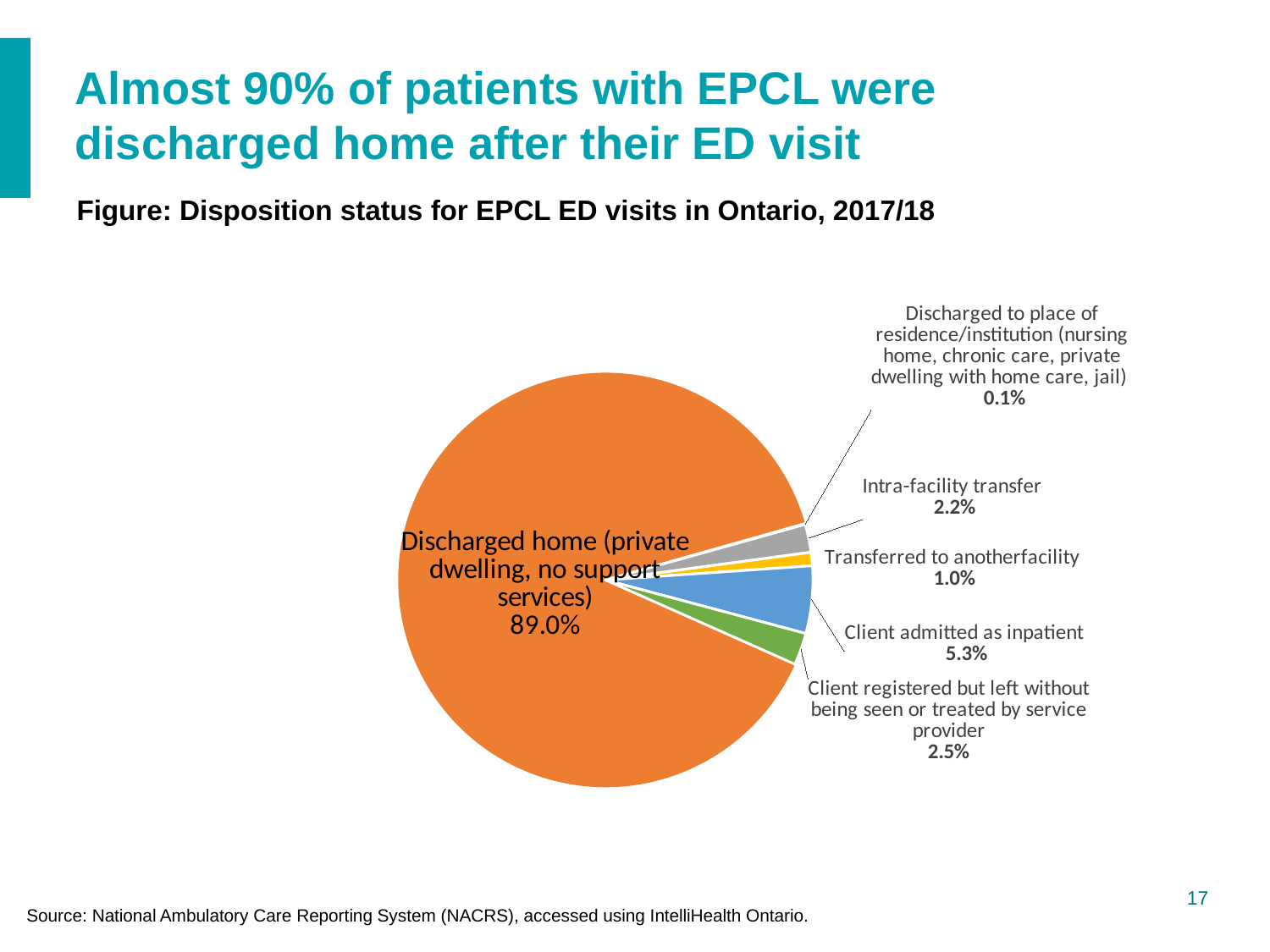
How many disposition categories are shown in the pie chart? 6 Which disposition status has the smallest share of the pie? Discharged to place of residence/institution (nursing home, chronic care, private dwelling with home care, jail) What share of EPCL ED visits were discharged home (private dwelling, no support services)? 89.0% What percentage of EPCL ED visits resulted in the client being admitted as an inpatient? 5.3% What is the difference in percentage points between clients admitted as inpatient and clients who left without being seen? 2.8 percentage points What percentage of clients registered but left without being seen or treated by a service provider? 2.5% What kind of chart is shown on the slide? Pie chart Which disposition status has the largest share of the pie? Discharged home (private dwelling, no support services) What share of visits were intra-facility transfers? 2.2% What share of visits were transferred to another facility? 1.0% Which is larger: the share for intra-facility transfer or the share transferred to another facility? Intra-facility transfer What percentage of visits were discharged to place of residence/institution (nursing home, chronic care, private dwelling with home care, jail)? 0.1%